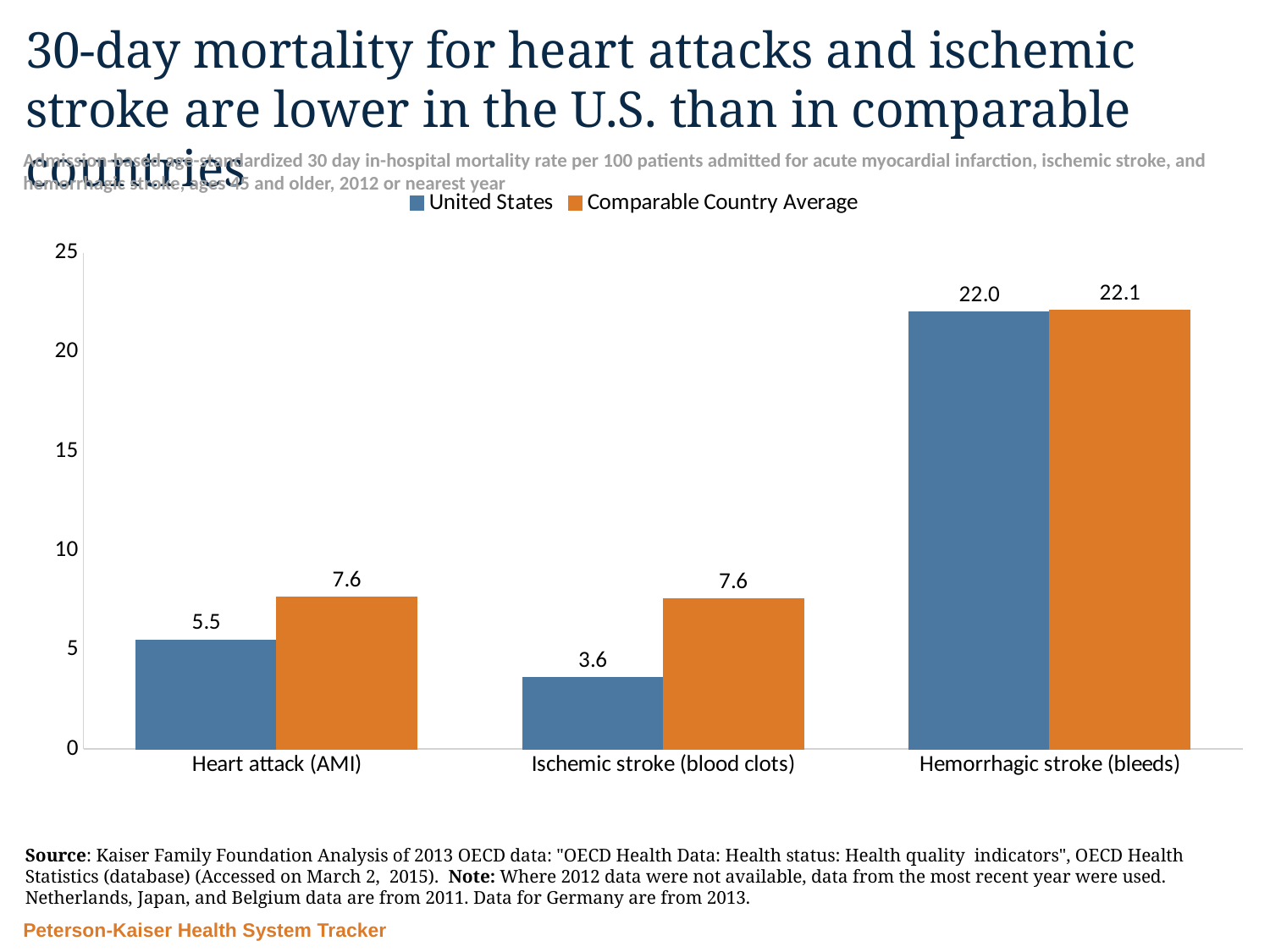
For Heart attack (AMI), which is larger: the United States value or the Comparable Country Average value? Comparable Country Average What kind of chart is shown on the slide? Bar chart What is the difference between the Comparable Country Average and the United States values for Heart attack (AMI)? 2.1 Which category has the highest Comparable Country Average value? Hemorrhagic stroke (bleeds) What is the United States value for Hemorrhagic stroke (bleeds)? 22.0 How many categories are shown on the x axis? 3 How many series does the legend list? 2 What is the United States value for Heart attack (AMI)? 5.5 What is the Comparable Country Average value for Hemorrhagic stroke (bleeds)? 22.1 Which category has the lowest United States value? Ischemic stroke (blood clots) What is the Comparable Country Average value for Ischemic stroke (blood clots)? 7.6 What is the difference between the Comparable Country Average and the United States values for Ischemic stroke (blood clots)? 4.0